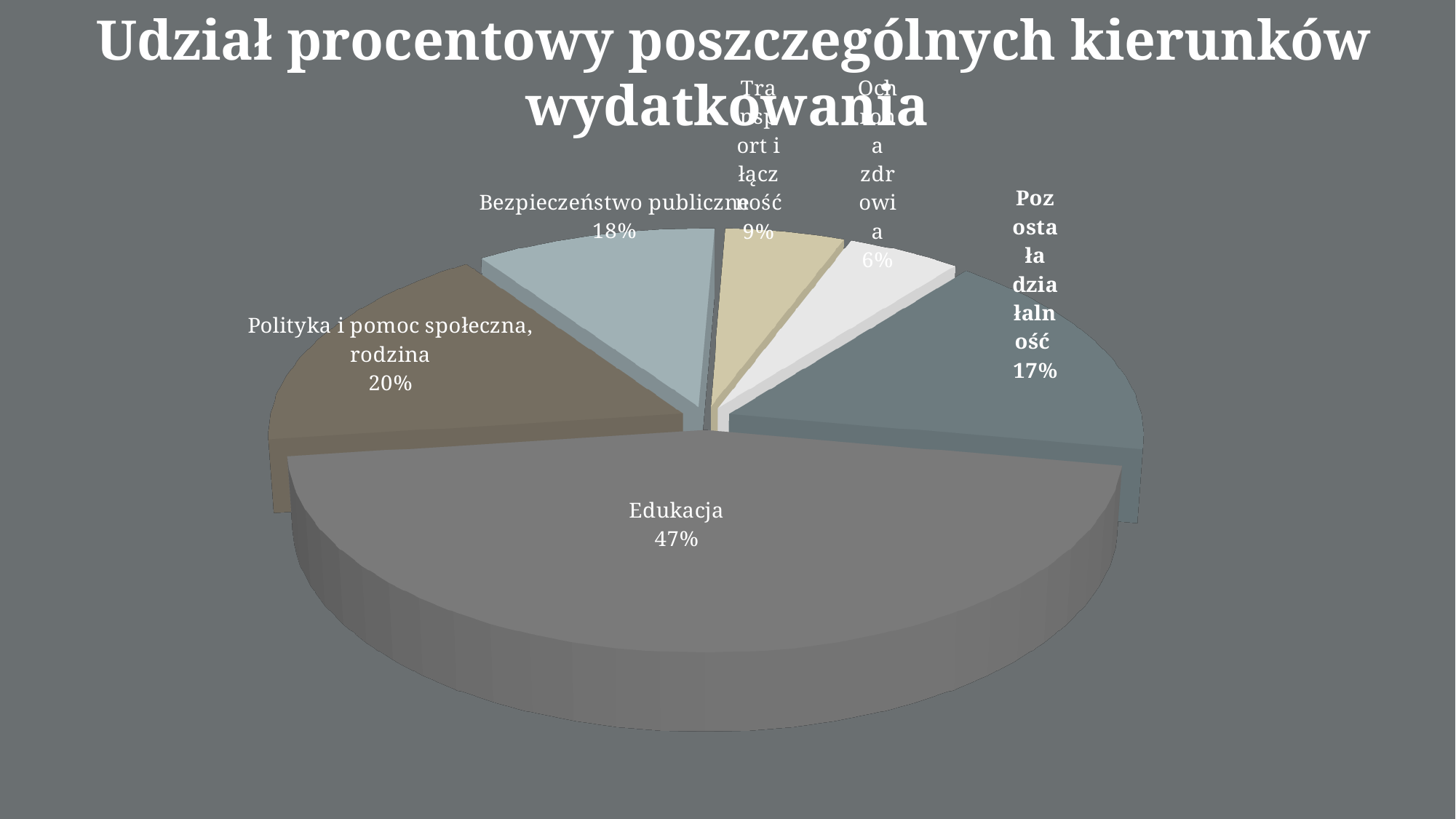
What is the title of the chart? Udział procentowy poszczególnych kierunków wydatkowania What percentage is shown for Polityka i pomoc społeczna, rodzina? 20% How many slices does the pie chart have? 6 What percentage is shown for Pozostała działalność? 17% Which is larger, the slice for Transport i łączność or the slice for Ochrona zdrowia? Transport i łączność What kind of chart is shown on the slide? pie chart What is the difference in percentage points between Edukacja and Polityka i pomoc społeczna, rodzina? 27 Which category has the largest slice of the pie? Edukacja What percentage is shown for Edukacja? 47% Which category has the smallest slice of the pie? Ochrona zdrowia What percentage is shown for Ochrona zdrowia? 6% What percentage is shown for Bezpieczeństwo publiczne? 18%